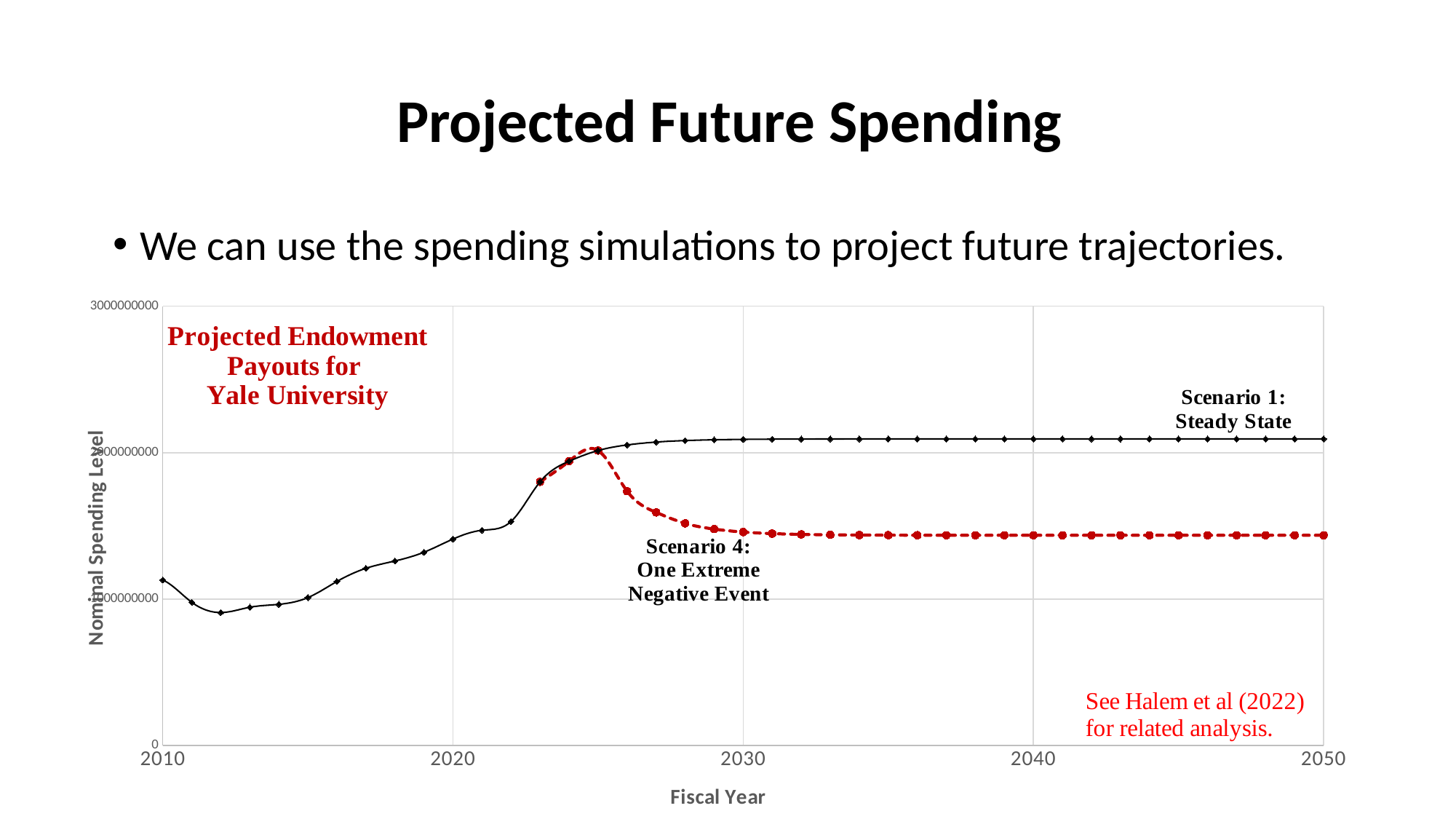
In which fiscal year does the Scenario 1: Steady State line reach its lowest value? 2012 In 2050, which scenario has the higher spending level, Scenario 1: Steady State or Scenario 4: One Extreme Negative Event? Scenario 1: Steady State What is the title of the chart? Projected Endowment Payouts for Yale University Is the Scenario 4: One Extreme Negative Event value in 2050 greater or less than 2000000000? less How many scenario series are plotted on the chart? 2 Does the Scenario 4: One Extreme Negative Event line rise or fall between 2025 and 2030? fall What is the label of the x axis? Fiscal Year Is the spending level in 2012 greater or less than 1000000000? less Is the Scenario 1: Steady State value in 2050 greater or less than 2000000000? greater What kind of chart is shown on the slide? Line chart